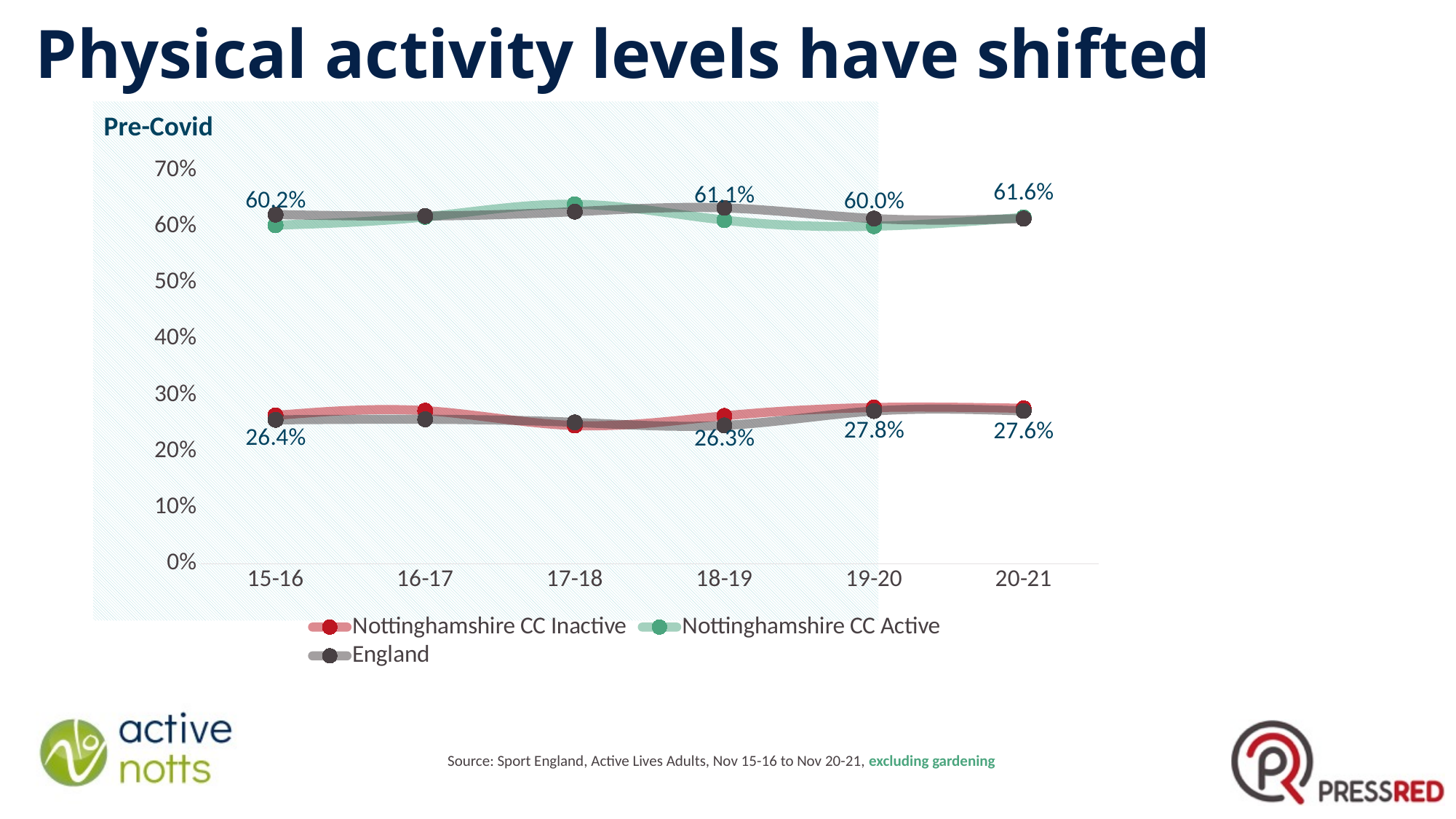
What is the labelled value for Nottinghamshire CC Active in 20-21? 61.6% What is the labelled value for Nottinghamshire CC Active in 15-16? 60.2% What is the labelled value for Nottinghamshire CC Inactive in 15-16? 26.4% Which year has the higher labelled Nottinghamshire CC Active value, 18-19 or 19-20? 18-19 What is the labelled value for Nottinghamshire CC Inactive in 19-20? 27.8% What kind of chart is shown on the slide? line chart What label appears in the top-left corner of the chart area? Pre-Covid How many time periods are shown on the x axis? 6 What is the difference between the Nottinghamshire CC Inactive values in 19-20 (27.8%) and 18-19 (26.3%)? 1.5 percentage points How many series does the legend list? 3 Is the Nottinghamshire CC Inactive value in 17-18 greater or less than 30%? less By how many percentage points did the Nottinghamshire CC Active value change from 15-16 (60.2%) to 20-21 (61.6%)? 1.4 percentage points